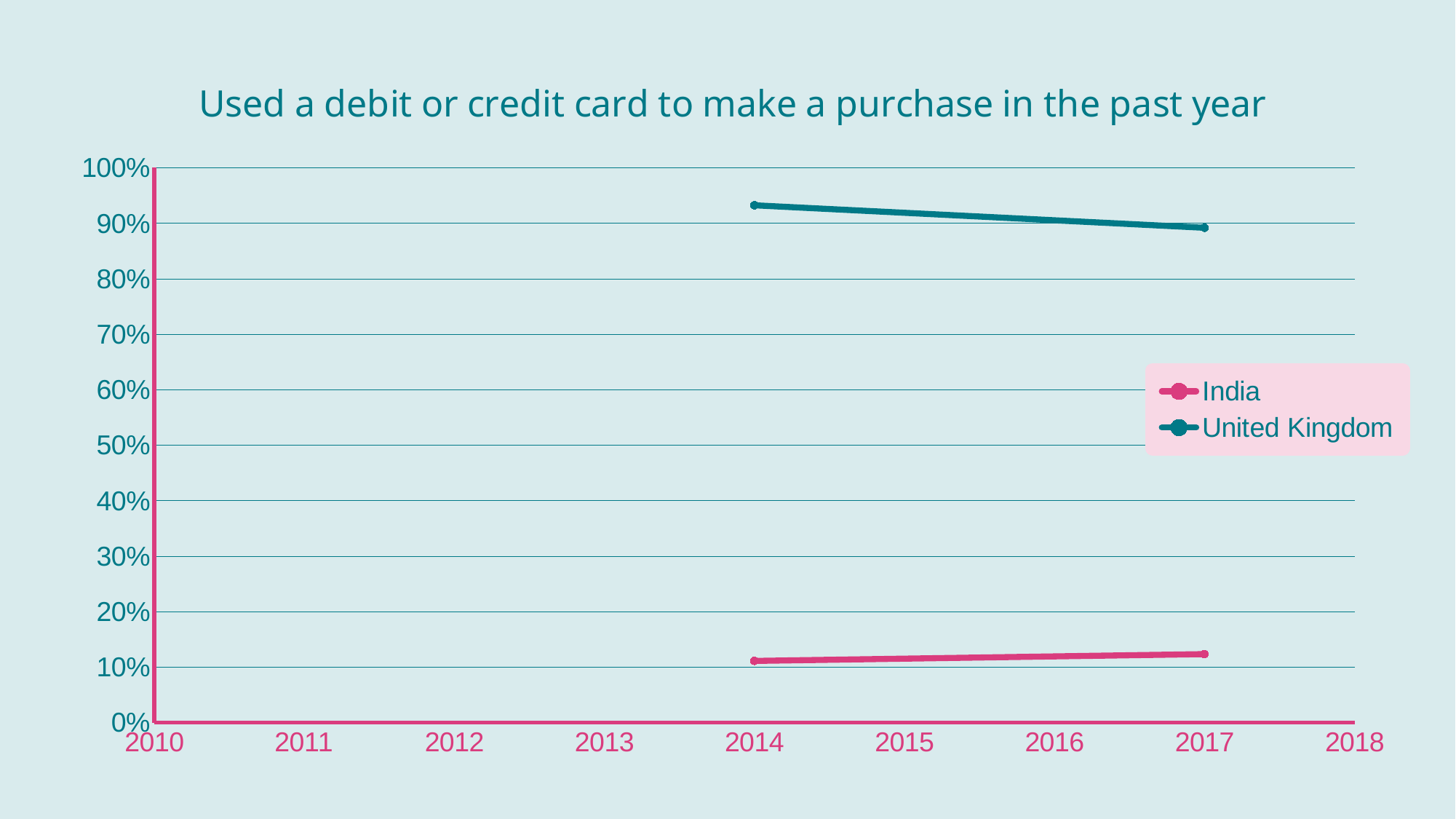
Is the value for India in 2017 greater or less than 10%? greater Is the value for the United Kingdom in 2014 greater or less than 90%? greater How many series does the legend list? 2 Which series has the higher value in 2017, India or United Kingdom? United Kingdom Does the United Kingdom line rise or fall from 2014 to 2017? fall How many data points are plotted for the United Kingdom series? 2 Is the value for India in 2014 greater or less than 20%? less What kind of chart is shown on the slide? line chart Does the India line rise or fall from 2014 to 2017? rise What is the title of the chart? Used a debit or credit card to make a purchase in the past year Which series is drawn in pink? India